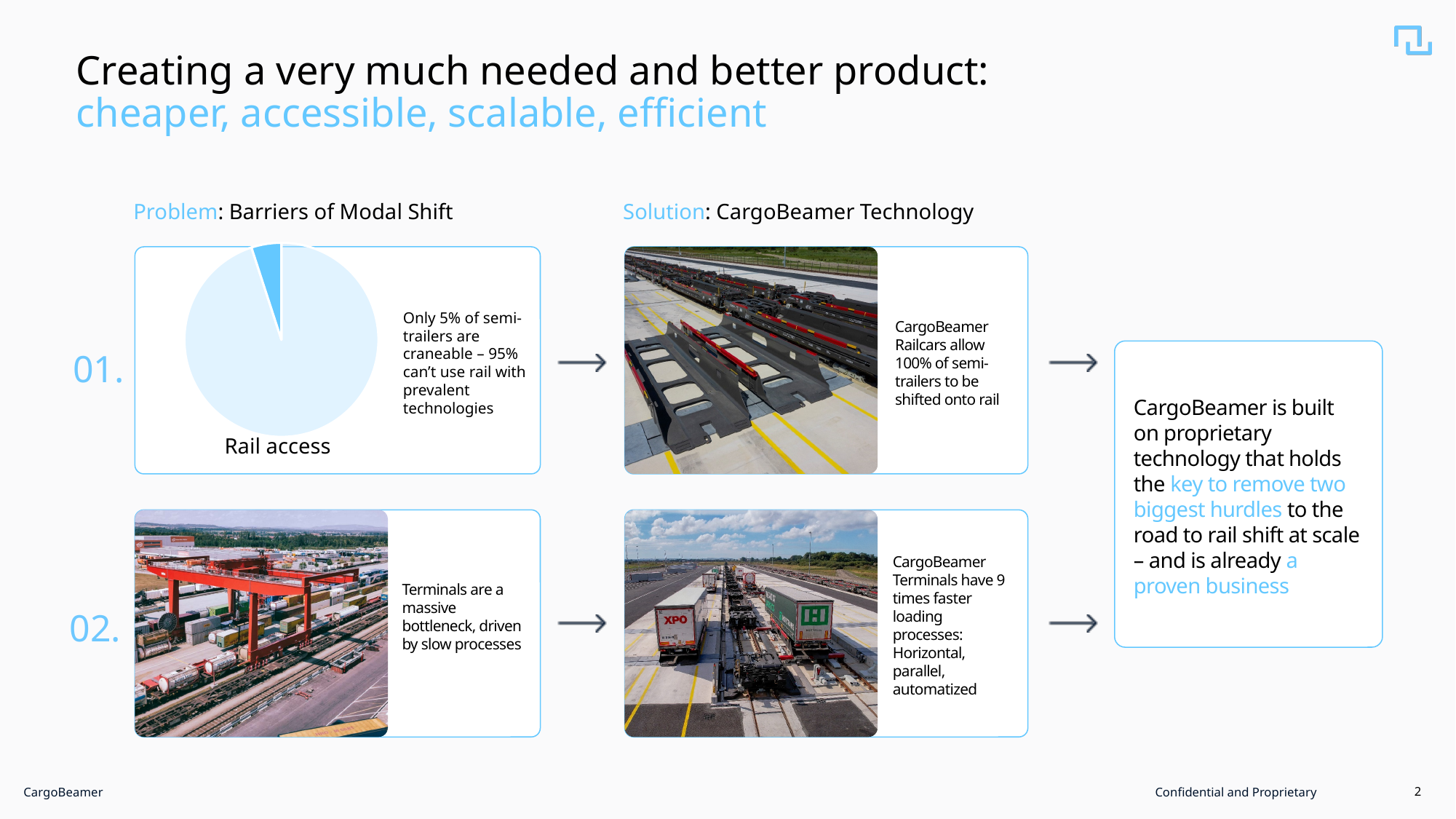
How many slices does the "Rail access" pie chart have? 2 What kind of chart is shown under "Problem: Barriers of Modal Shift"? Pie chart In the "Rail access" pie chart, what colour is the small 5% slice compared with the large slice? A darker, more saturated blue than the pale light-blue large slice In the "Rail access" pie chart, is the larger slice greater or less than 50%? greater In the "Rail access" pie chart, what share of semi-trailers can't use rail with prevalent technologies? 95% In the "Rail access" pie chart, by how many percentage points does the share of semi-trailers that can't use rail exceed the craneable share? 90 percentage points What is the title of the pie chart on the slide? Rail access In the "Rail access" pie chart, which slice is the smallest? Craneable semi-trailers (5%) In the "Rail access" pie chart, what share of semi-trailers is craneable? 5% In the "Rail access" pie chart, which slice is larger: craneable semi-trailers or those that can't use rail? Those that can't use rail